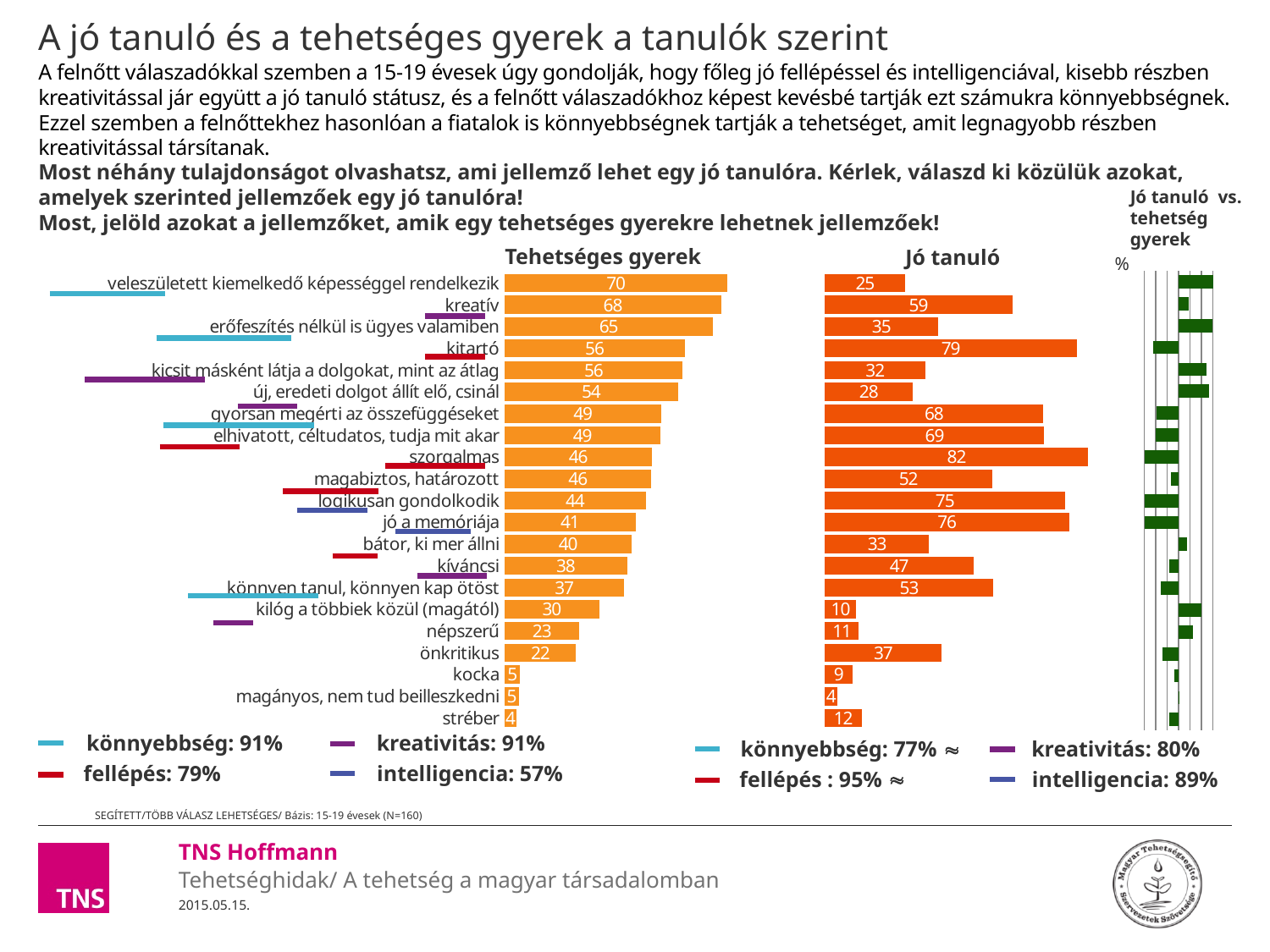
In the Jó tanuló chart, what is the difference between the values for szorgalmas and kocka? 73 In the Tehetséges gyerek chart, which category has the highest value? veleszületett kiemelkedő képességgel rendelkezik In the Jó tanuló chart, which category has the highest value? szorgalmas In the Tehetséges gyerek chart, what is the value for kreatív? 68 In the Jó tanuló chart, which category has the lowest value? magányos, nem tud beilleszkedni How many categories are listed in the Tehetséges gyerek chart? 21 What kind of chart is the Jó tanuló chart? bar chart In the Jó tanuló chart, what is the value for kilóg a többiek közül (magától)? 10 For kreatív, which chart shows the larger value, Tehetséges gyerek or Jó tanuló? Tehetséges gyerek In the Tehetséges gyerek chart, which category has the lowest value? stréber What is the difference between the value for kitartó in the Jó tanuló chart and in the Tehetséges gyerek chart? 23 In the Jó tanuló chart, what is the value for szorgalmas? 82